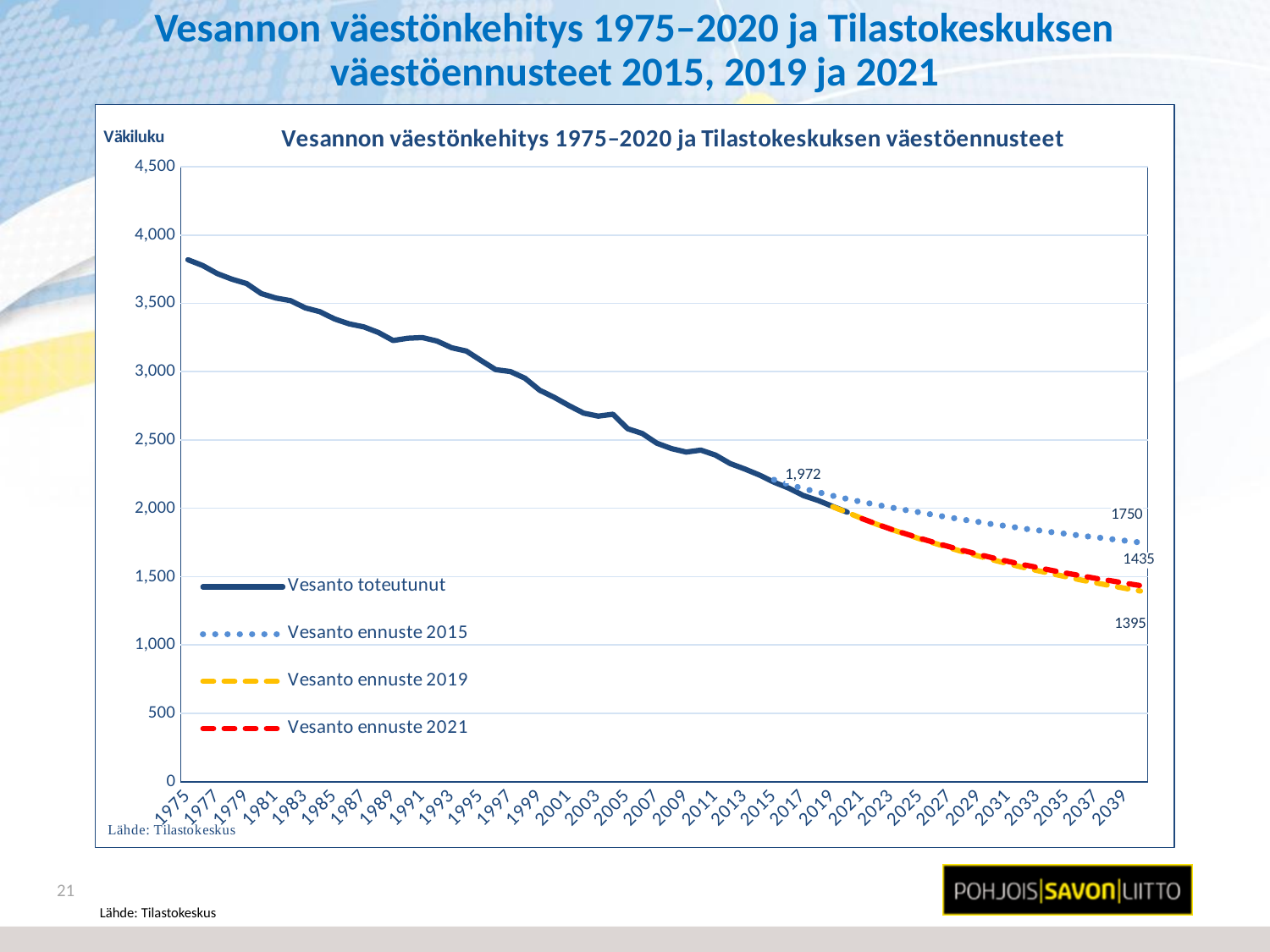
What is the final labelled value of the Vesanto ennuste 2021 series? 1435 Does the Vesanto toteutunut series rise or fall from 1975 to 2020? fall What is the final labelled value of the Vesanto ennuste 2015 series? 1750 What kind of chart is shown on the slide? line chart What label is shown on the vertical axis of the chart? Väkiluku How many series does the legend list? 4 Which forecast series has the highest value at the end of the chart? Vesanto ennuste 2015 What is the difference between the final labelled values of the ennuste 2021 (1435) and ennuste 2019 (1395) series? 40 Which forecast series ends at a higher value, Vesanto ennuste 2015 or Vesanto ennuste 2019? Vesanto ennuste 2015 Is the Vesanto toteutunut value in 1975 greater or less than 3,500? greater What is the final labelled value of the Vesanto ennuste 2019 series? 1395 What is the difference between the final labelled values of the ennuste 2015 (1750) and ennuste 2019 (1395) series? 355